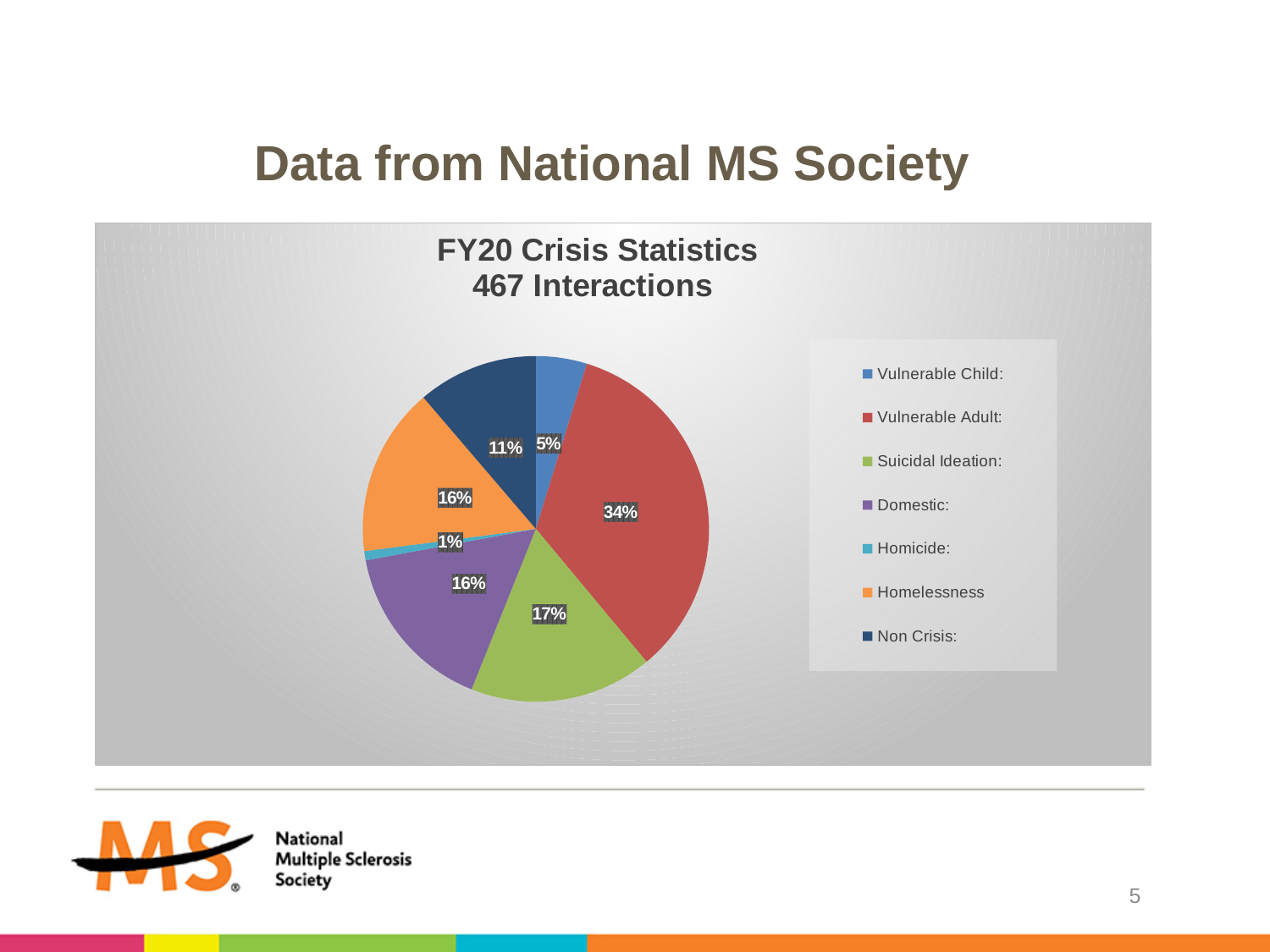
Which category has the smallest slice of the pie? Homicide What percentage is shown for Non Crisis? 11% What kind of chart is shown on the slide? Pie chart How many categories does the legend list? 7 What is the difference in percentage points between Vulnerable Adult and Suicidal Ideation? 17 Which category has the largest slice of the pie? Vulnerable Adult What percentage is shown for Vulnerable Child? 5% What percentage is shown for Suicidal Ideation? 17% What is the title of the chart? FY20 Crisis Statistics 467 Interactions What is the difference in percentage points between Domestic and Homicide? 15 What share of the pie does Vulnerable Adult represent? 34% Which is larger, the share for Non Crisis or the share for Vulnerable Child? Non Crisis